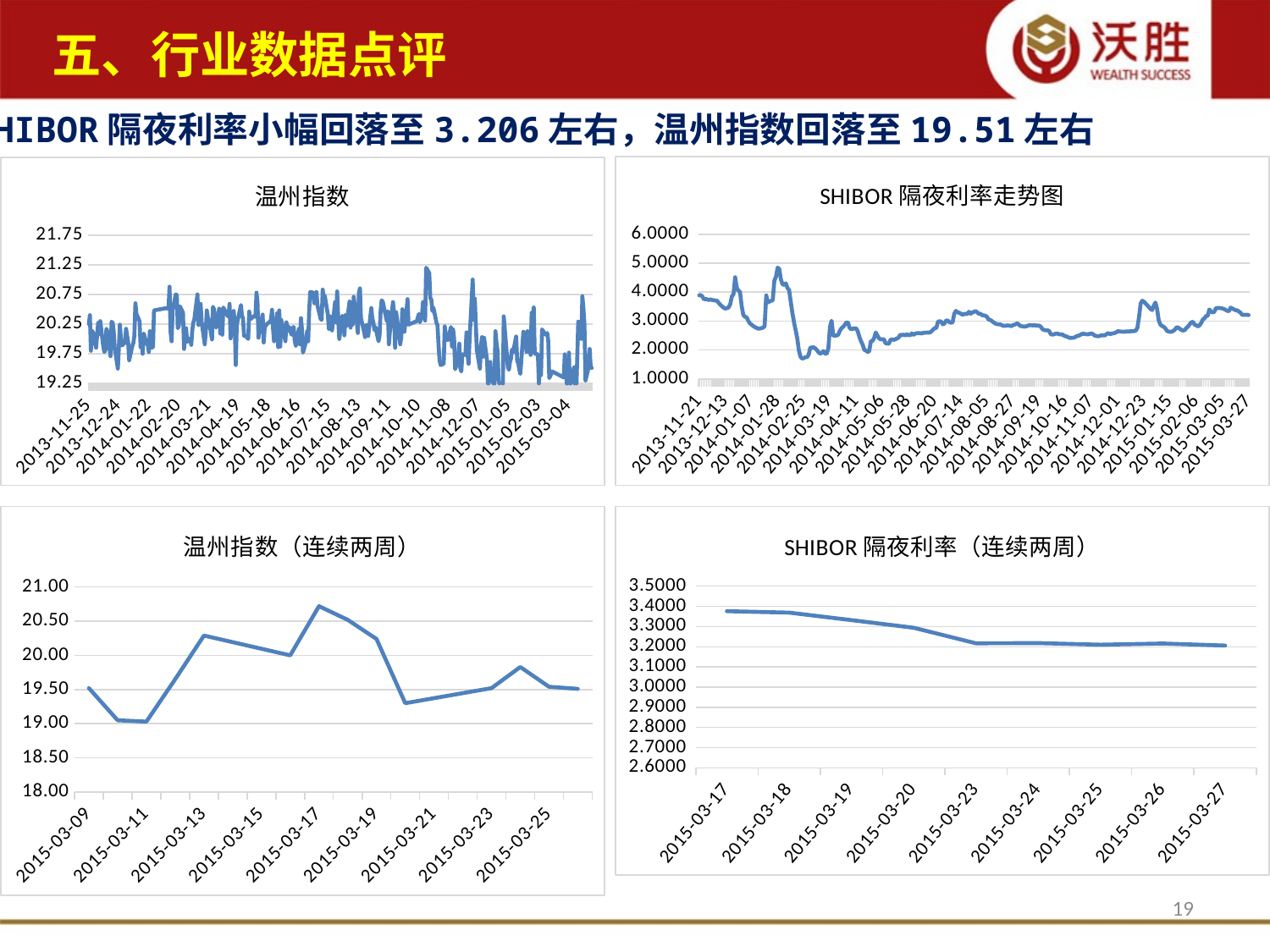
In the top-right chart SHIBOR 隔夜利率走势图, is the peak value near 2014-01-28 greater or less than 4.0000? greater In the bottom-left chart 温州指数（连续两周）, which of the two dates has the larger value, 2015-03-17 or 2015-03-21? 2015-03-17 What kind of chart is the top-left chart titled 温州指数? line chart In the bottom-left chart 温州指数（连续两周）, is the value for 2015-03-11 greater or less than 19.50? less What kind of chart is the bottom-right chart titled SHIBOR 隔夜利率（连续两周）? line chart In the bottom-right chart SHIBOR 隔夜利率（连续两周）, is the value for 2015-03-17 greater or less than 3.3000? greater In the bottom-right chart SHIBOR 隔夜利率（连续两周）, how many dates are shown on the x axis? 9 In the bottom-right chart SHIBOR 隔夜利率（连续两周）, do the values rise or fall from 2015-03-17 to 2015-03-27? fall What is the title of the top-right chart on the slide? SHIBOR 隔夜利率走势图